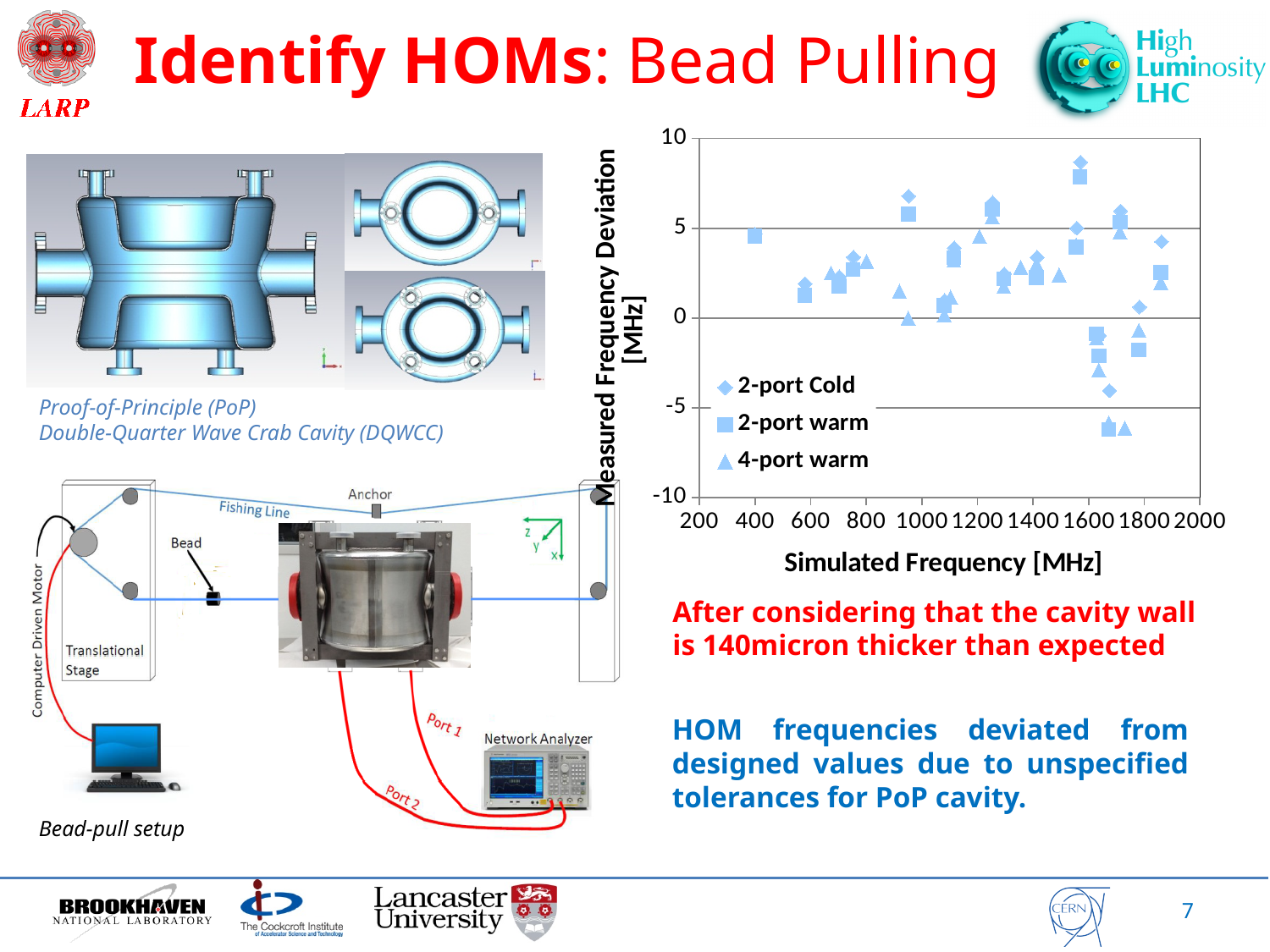
Is the measured frequency deviation of the 2-port warm point at about 400 MHz simulated frequency greater or less than 0? greater What are the three series listed in the chart legend? 2-port Cold, 2-port warm, 4-port warm Which series contains the single highest measured frequency deviation on the chart? 2-port Cold Is the highest 2-port Cold point on the chart greater or less than 5 MHz deviation? greater Are the lowest points on the chart, near 1700 MHz simulated frequency, greater or less than -5 MHz deviation? less What kind of chart is shown on the slide? scatter chart How many series does the chart legend list? 3 What is the title of the chart's x axis? Simulated Frequency [MHz]